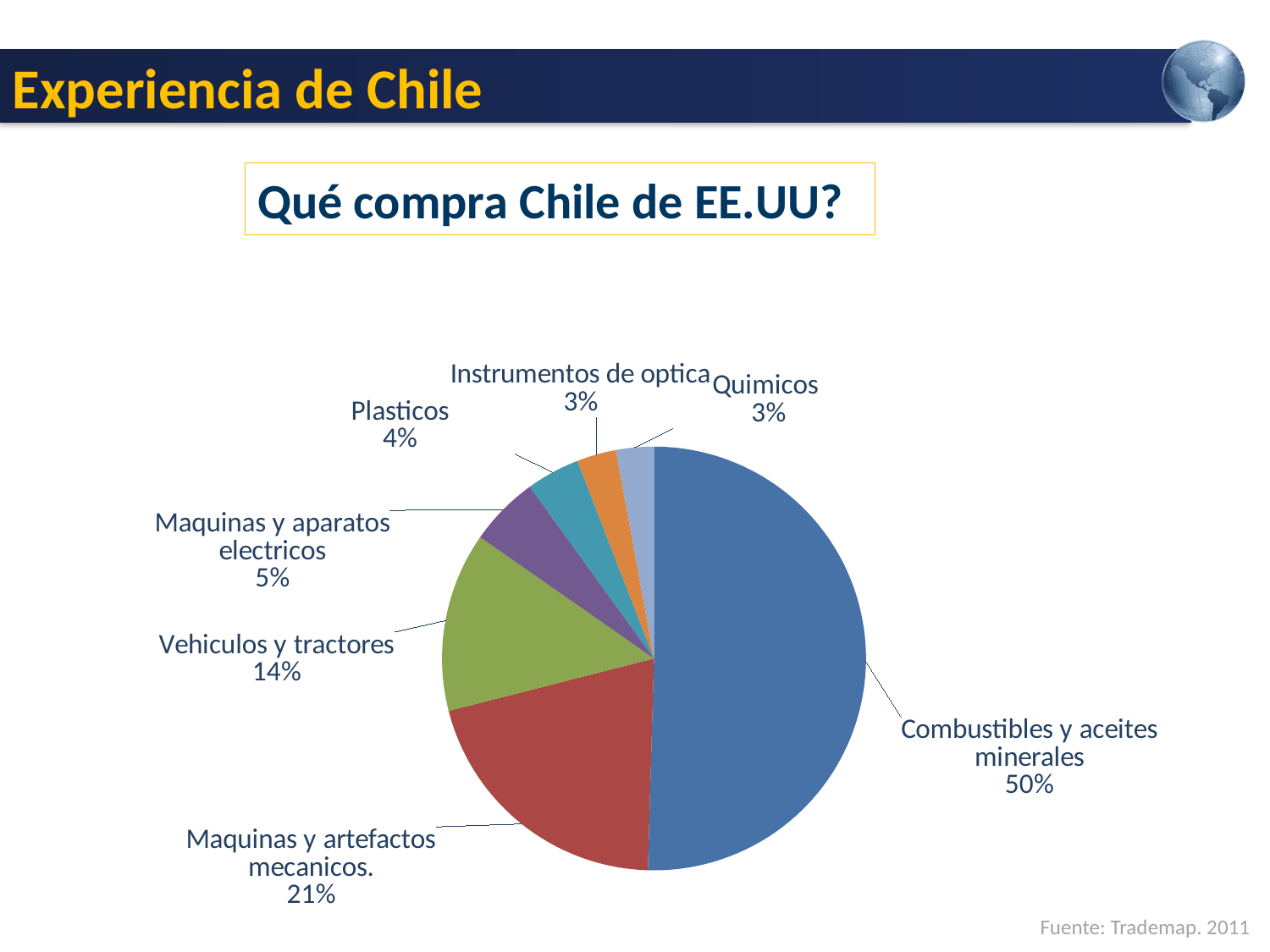
What kind of chart is shown on the slide? Pie chart Which is larger, the share for Vehiculos y tractores or the share for Maquinas y aparatos electricos? Vehiculos y tractores What is the value shown for Maquinas y artefactos mecanicos.? 21% What is the title shown above the chart? Qué compra Chile de EE.UU? What is the source cited for the chart data? Trademap. 2011 Which category has the largest slice of the pie? Combustibles y aceites minerales What is the difference between the shares of Maquinas y artefactos mecanicos. and Vehiculos y tractores? 7% What is the value shown for Vehiculos y tractores? 14% What is the value shown for Plasticos? 4% What is the value shown for Maquinas y aparatos electricos? 5% How many categories are shown in the pie chart? 7 What share of the pie does Combustibles y aceites minerales represent? 50%